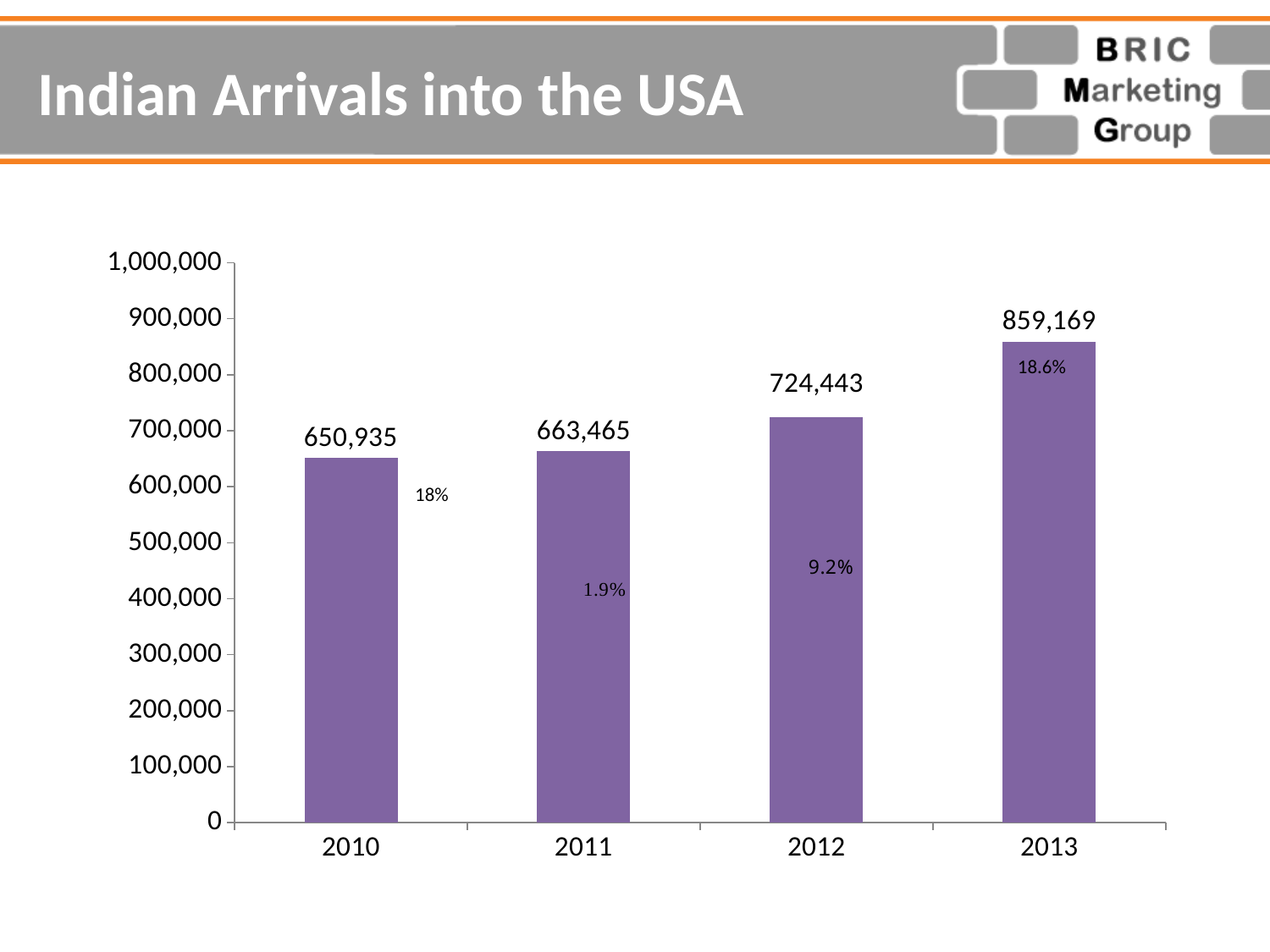
What is the value for 2013? 859,169 What is the value for 2010? 650,935 What is the difference between the values for 2013 and 2012? 134,726 What is the value for 2012? 724,443 Do the values rise or fall from 2010 to 2013? rise Is the value for 2013 greater or less than 800,000? greater Which year has the lowest value? 2010 How many years are shown on the x axis? 4 What kind of chart is shown on the slide? bar chart Which year has the highest value? 2013 What is the difference between the values for 2011 and 2010? 12,530 Which is larger, the value for 2012 or the value for 2011? 2012